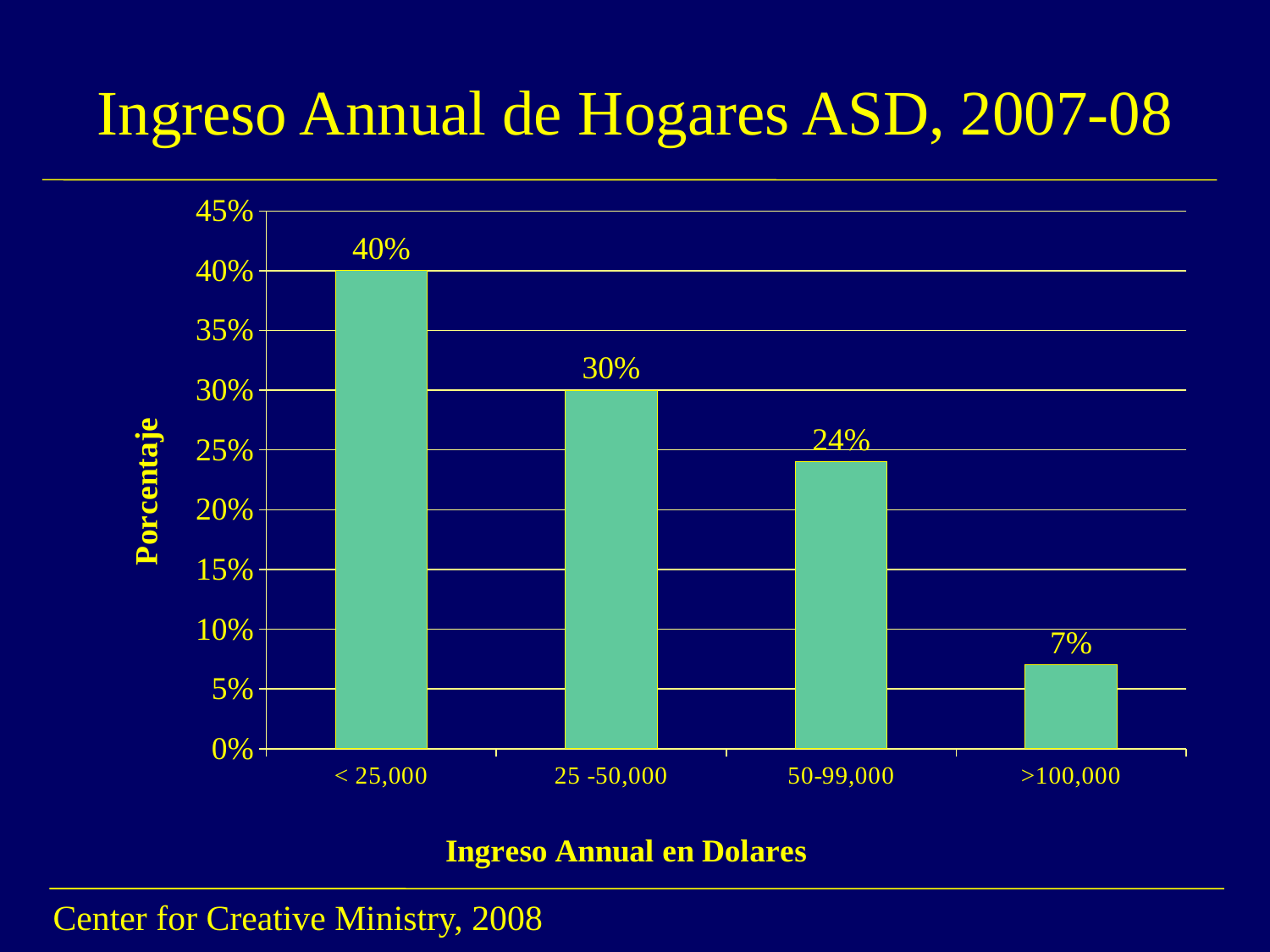
What kind of chart is shown on the slide? Bar chart Which income category has the lowest percentage? >100,000 How many income categories are shown on the x axis? 4 What is the value for the >100,000 income category? 7% Which income category has the highest percentage? < 25,000 What is the label of the x axis? Ingreso Annual en Dolares Do the values rise or fall as income increases along the x axis? Fall What percentage is shown for the 50-99,000 category? 24% What percentage of households have an annual income of < 25,000? 40% What is the value for the 25 -50,000 income category? 30% What is the difference in percentage points between the < 25,000 and 25 -50,000 categories? 10% Which is larger, the value for 50-99,000 or the value for >100,000? 50-99,000